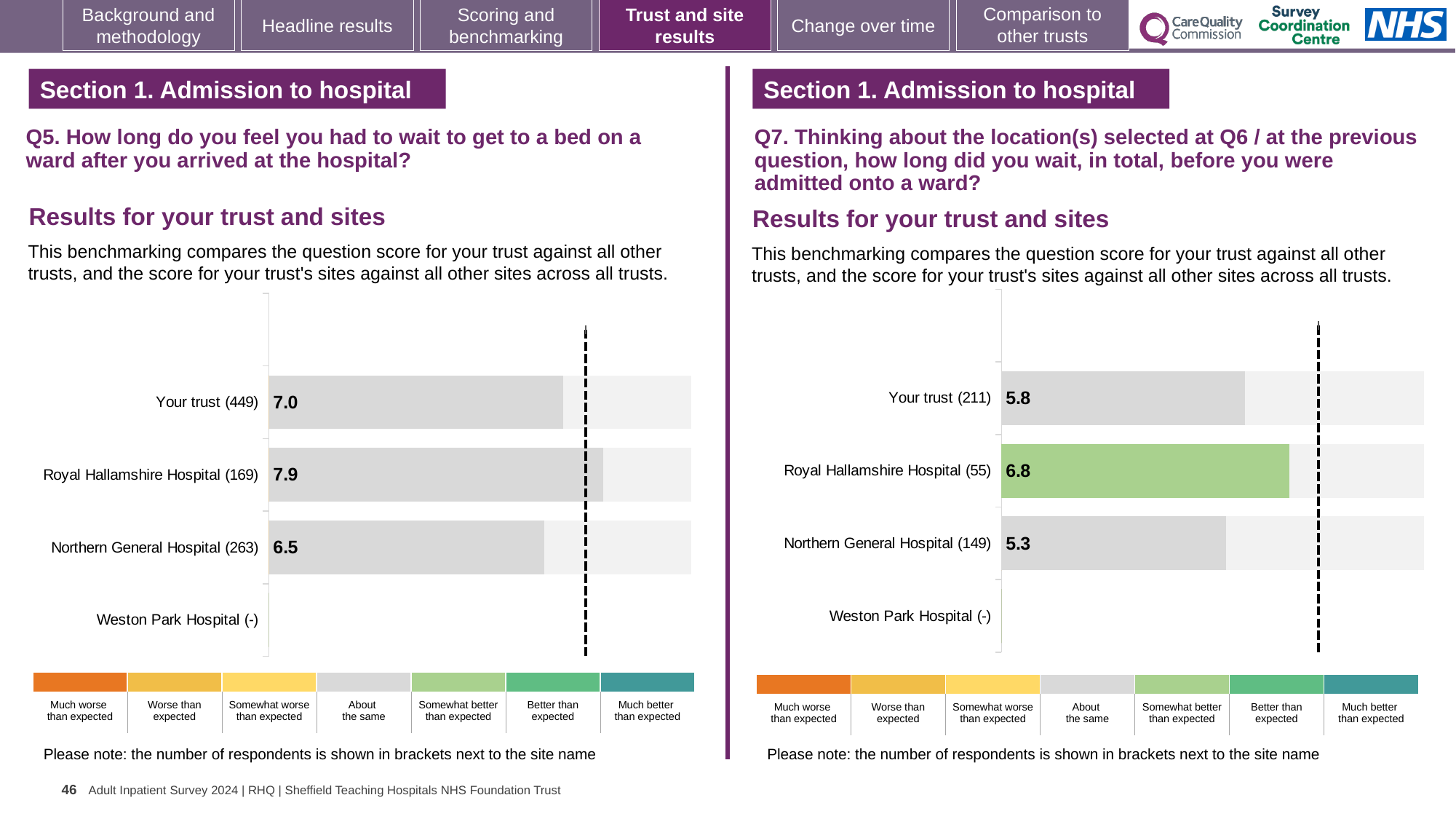
On the Q5 chart (left), what is the score for Northern General Hospital (263)? 6.5 On the Q5 chart (left), which site has the highest score? Royal Hallamshire Hospital (169) On the Q7 chart (right), which site has the lowest score? Northern General Hospital (149) On the Q5 chart (left), what is the score for Your trust (449)? 7.0 What kind of chart is the Q7 chart (right)? Bar chart On the Q7 chart (right), what is the score for Your trust (211)? 5.8 On the Q7 chart (right), what is the difference between the scores for Your trust and Northern General Hospital? 0.5 How many categories are listed on the y axis of the Q5 chart (left)? 4 On the Q7 chart (right), which benchmark category does the green colour of the Royal Hallamshire Hospital bar correspond to in the legend? Somewhat better than expected On the Q5 chart (left), what is the difference between the scores for Royal Hallamshire Hospital and Northern General Hospital? 1.4 On the Q7 chart (right), what is the score for Royal Hallamshire Hospital (55)? 6.8 On the Q7 chart (right), which is larger: the score for Your trust or the score for Royal Hallamshire Hospital? Royal Hallamshire Hospital